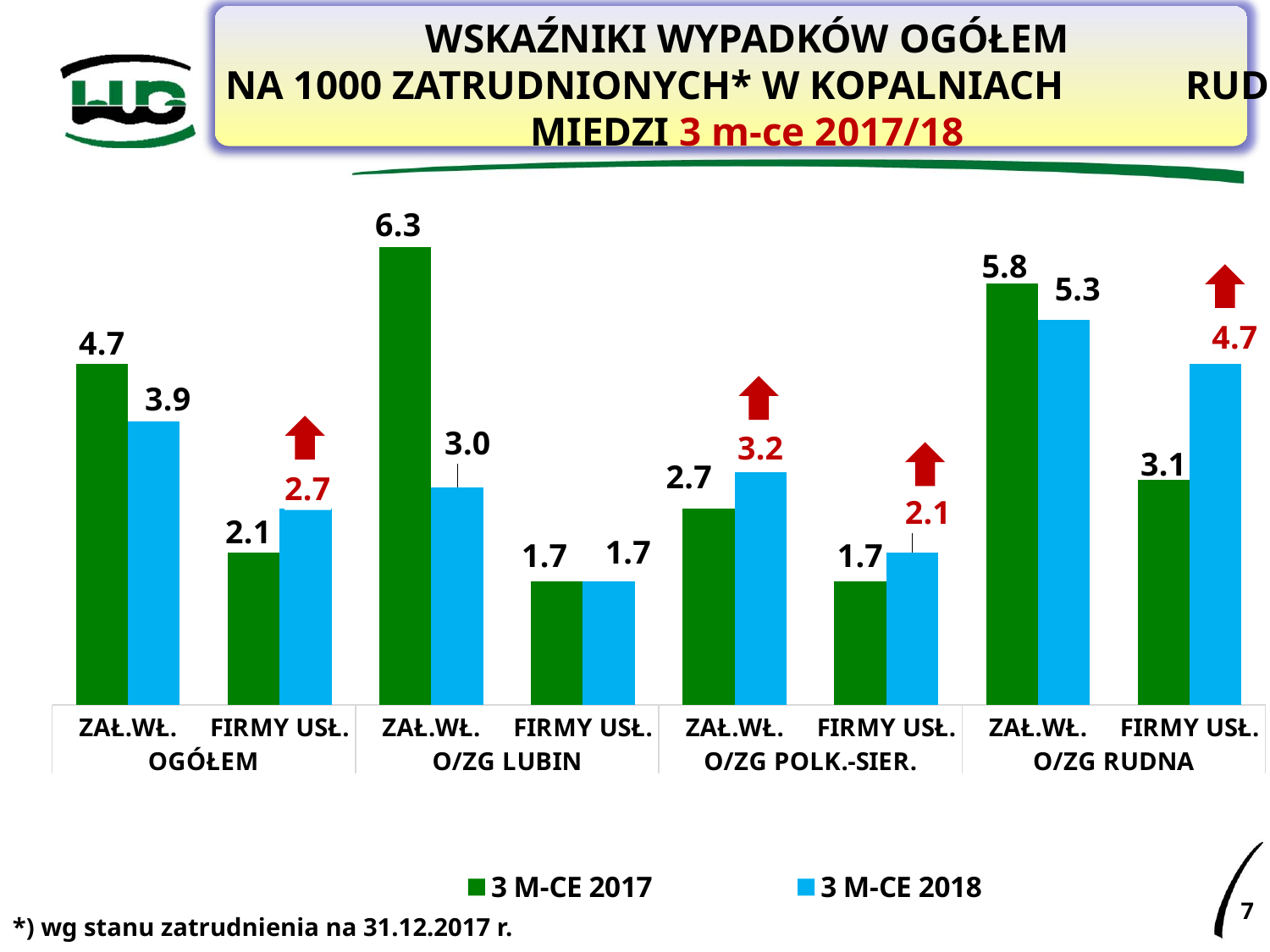
What kind of chart is shown on the slide? Bar chart What is the difference between the 3 M-CE 2017 and 3 M-CE 2018 values for ZAŁ.WŁ. in O/ZG LUBIN? 3.3 How many series does the legend list? 2 What is the difference between the 3 M-CE 2018 and 3 M-CE 2017 values for FIRMY USŁ. in O/ZG RUDNA? 1.6 Which category has the highest value in the 3 M-CE 2017 series? ZAŁ.WŁ. in O/ZG LUBIN What is the value for ZAŁ.WŁ. in O/ZG LUBIN for the 3 M-CE 2017 series? 6.3 For ZAŁ.WŁ. in O/ZG RUDNA, which series has the larger value, 3 M-CE 2017 or 3 M-CE 2018? 3 M-CE 2017 What is the value for FIRMY USŁ. in O/ZG RUDNA for the 3 M-CE 2018 series? 4.7 For FIRMY USŁ. in OGÓŁEM, which series has the larger value, 3 M-CE 2017 or 3 M-CE 2018? 3 M-CE 2018 What is the value for FIRMY USŁ. in O/ZG POLK.-SIER. for the 3 M-CE 2017 series? 1.7 Which category has the highest value in the 3 M-CE 2018 series? ZAŁ.WŁ. in O/ZG RUDNA What is the value for ZAŁ.WŁ. in OGÓŁEM for the 3 M-CE 2018 series? 3.9